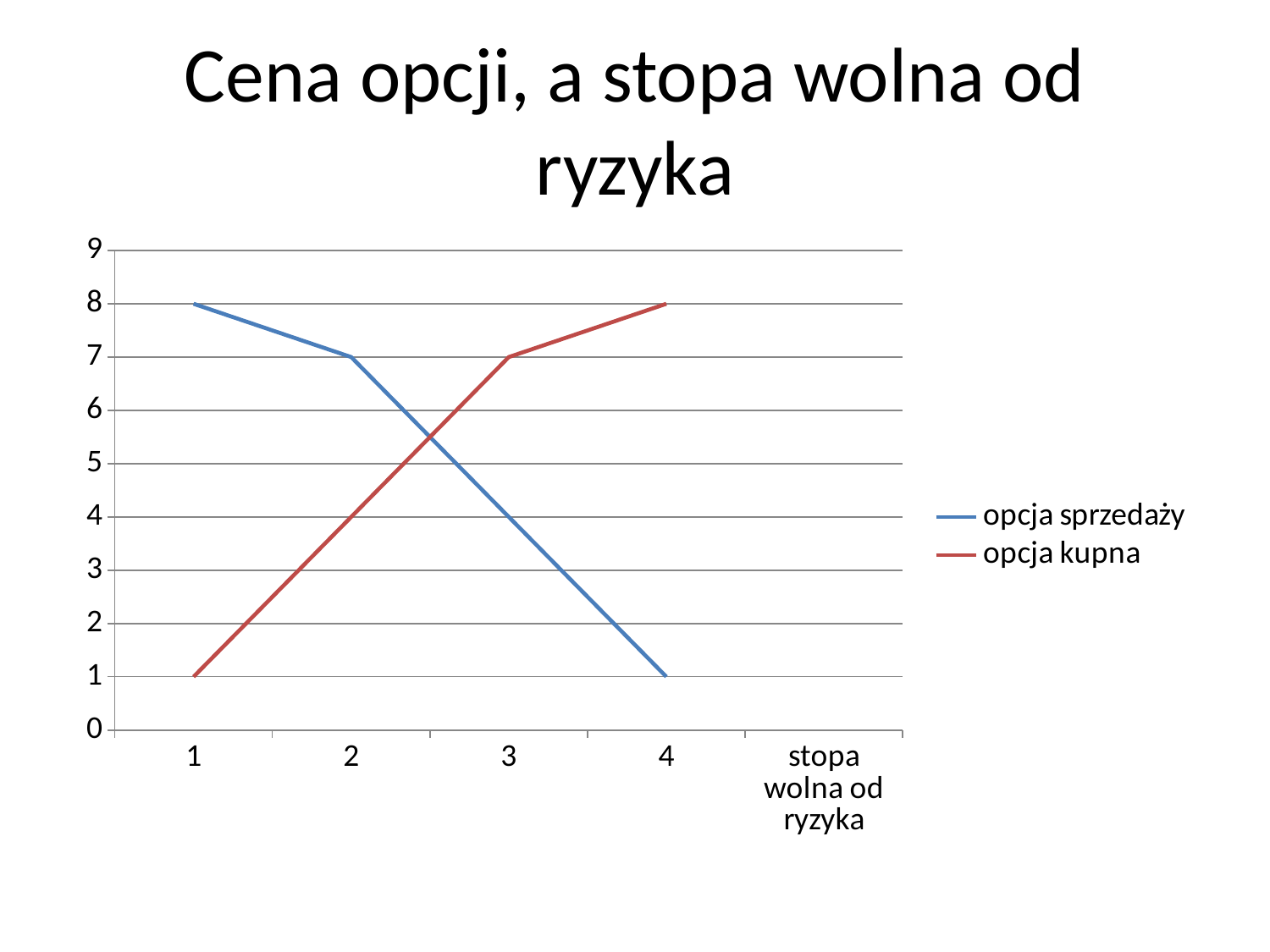
Does the opcja sprzedaży line rise or fall from category 1 to category 4? fall At which category is opcja sprzedaży lowest? 4 What is the value of opcja kupna at category 1? 1 What is the difference between opcja sprzedaży and opcja kupna at category 1? 7 What is the title of the chart? Cena opcji, a stopa wolna od ryzyka What is the value of opcja kupna at category 3? 7 How many series does the legend list? 2 At which category is opcja kupna highest? 4 Which series has the larger value at category 3, opcja sprzedaży or opcja kupna? opcja kupna What is the value of opcja sprzedaży at category 1? 8 What is the value of opcja sprzedaży at category 4? 1 What kind of chart is shown on the slide? line chart